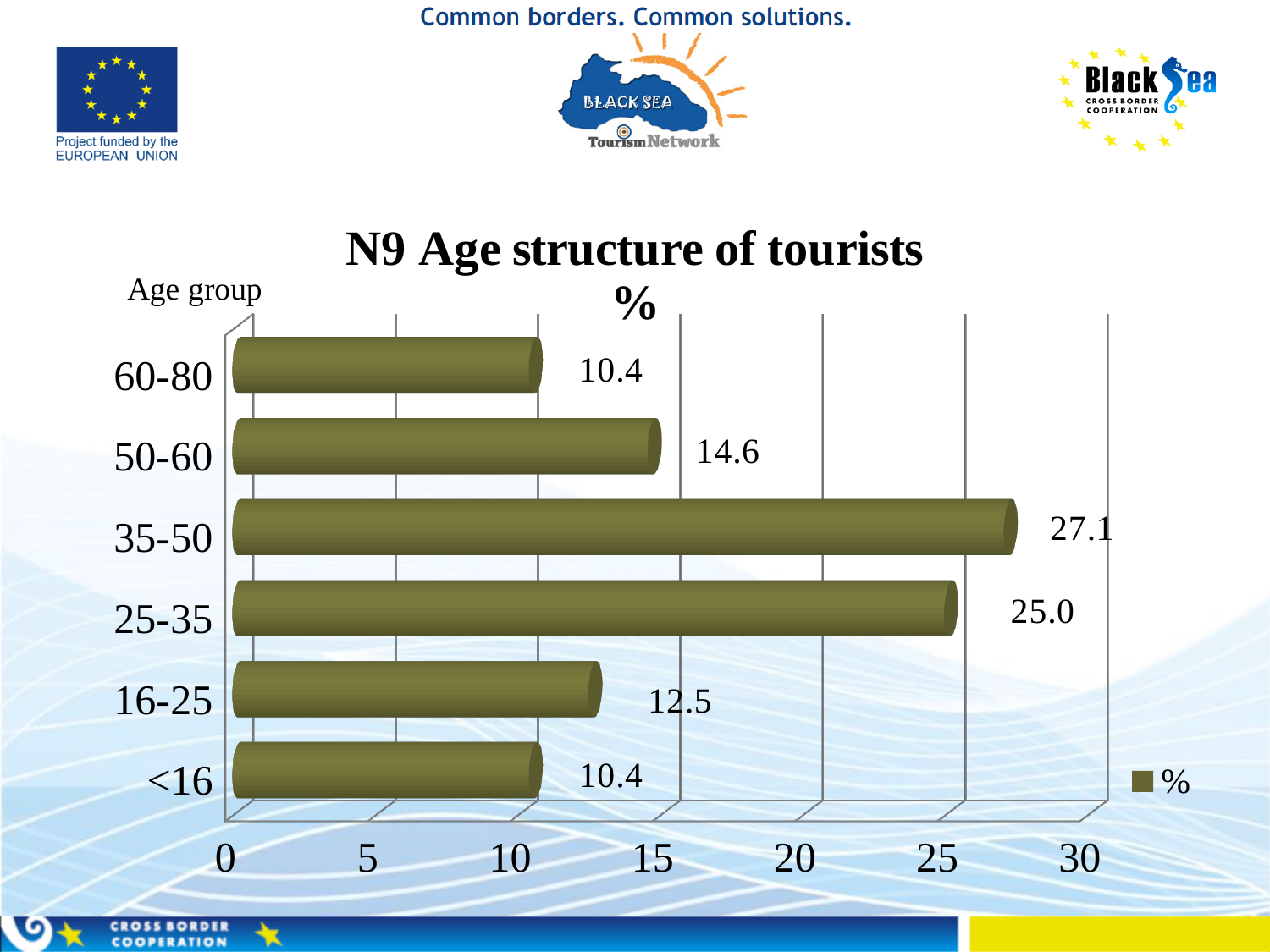
What is the value for the 50-60 age group? 14.6 How many age groups are shown in the chart? 6 Which is larger, the value for 50-60 or the value for 60-80? 50-60 What is the difference between the values for the 50-60 and 16-25 age groups? 2.1 What is the value for the 25-35 age group? 25.0 Which age group has the highest value? 35-50 What is the difference between the values for the 35-50 and 25-35 age groups? 2.1 How many series does the legend list? 1 What kind of chart is shown on the slide? bar chart What is the value for the 35-50 age group? 27.1 What is the value for the 16-25 age group? 12.5 What is the title of the chart? N9 Age structure of tourists %